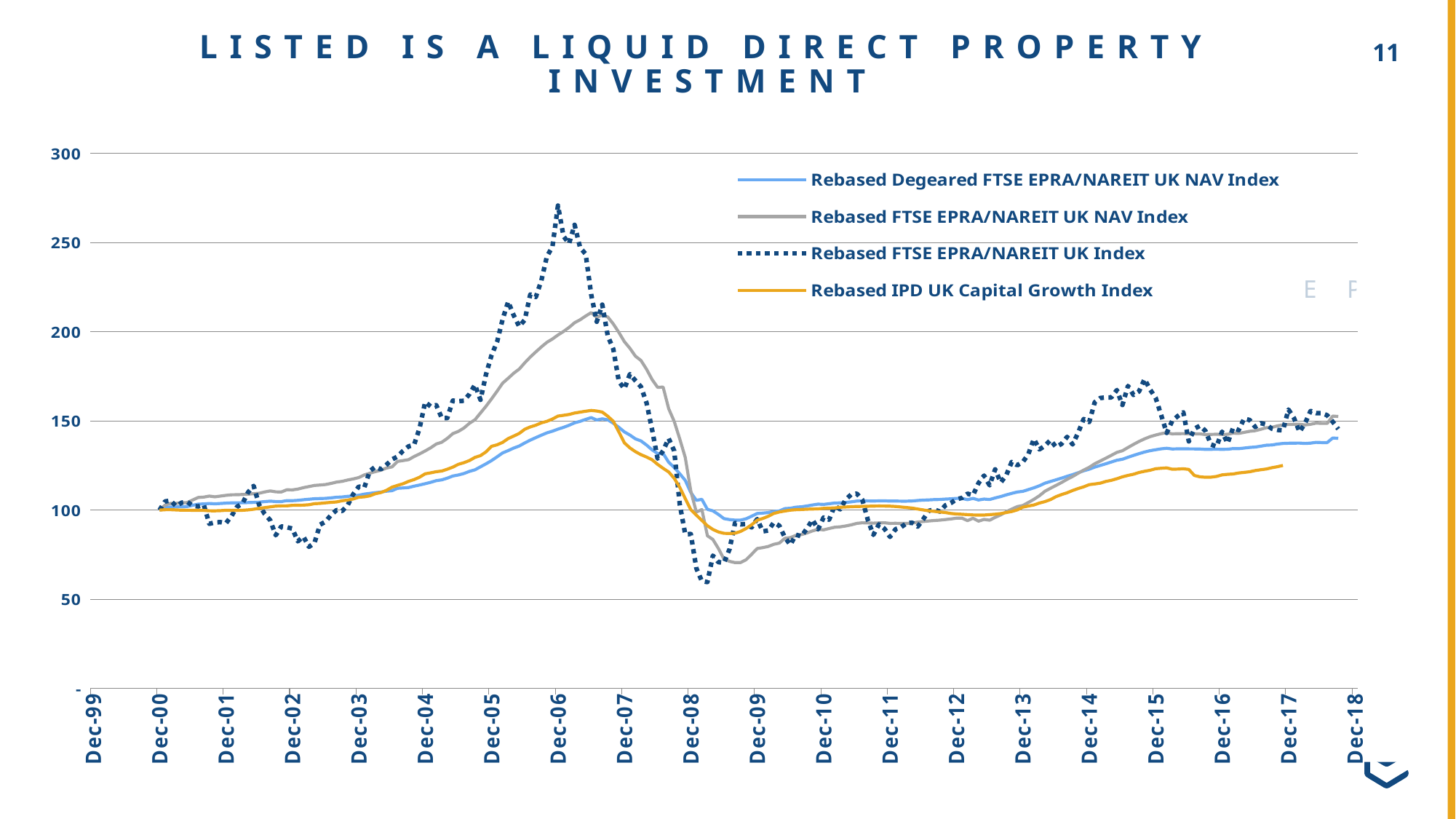
What kind of chart is shown on the slide? line chart Is the highest value reached by the Rebased FTSE EPRA/NAREIT UK NAV Index greater or less than 200? greater Between Dec-12 and Dec-15, does the Rebased IPD UK Capital Growth Index rise or fall? rise Is the lowest value of the Rebased FTSE EPRA/NAREIT UK Index around Dec-08 greater or less than 100? less What is the title of the slide? LISTED IS A LIQUID DIRECT PROPERTY INVESTMENT Which series is drawn as a dotted line? Rebased FTSE EPRA/NAREIT UK Index How many series does the legend list? 4 Which series reaches the highest value anywhere on the chart? Rebased FTSE EPRA/NAREIT UK Index Is the value of the Rebased IPD UK Capital Growth Index at Dec-17 greater or less than 150? less At Dec-17, which is higher: the Rebased IPD UK Capital Growth Index or the Rebased Degeared FTSE EPRA/NAREIT UK NAV Index? Rebased Degeared FTSE EPRA/NAREIT UK NAV Index Between Dec-06 and Dec-08, does the Rebased FTSE EPRA/NAREIT UK NAV Index rise or fall? fall